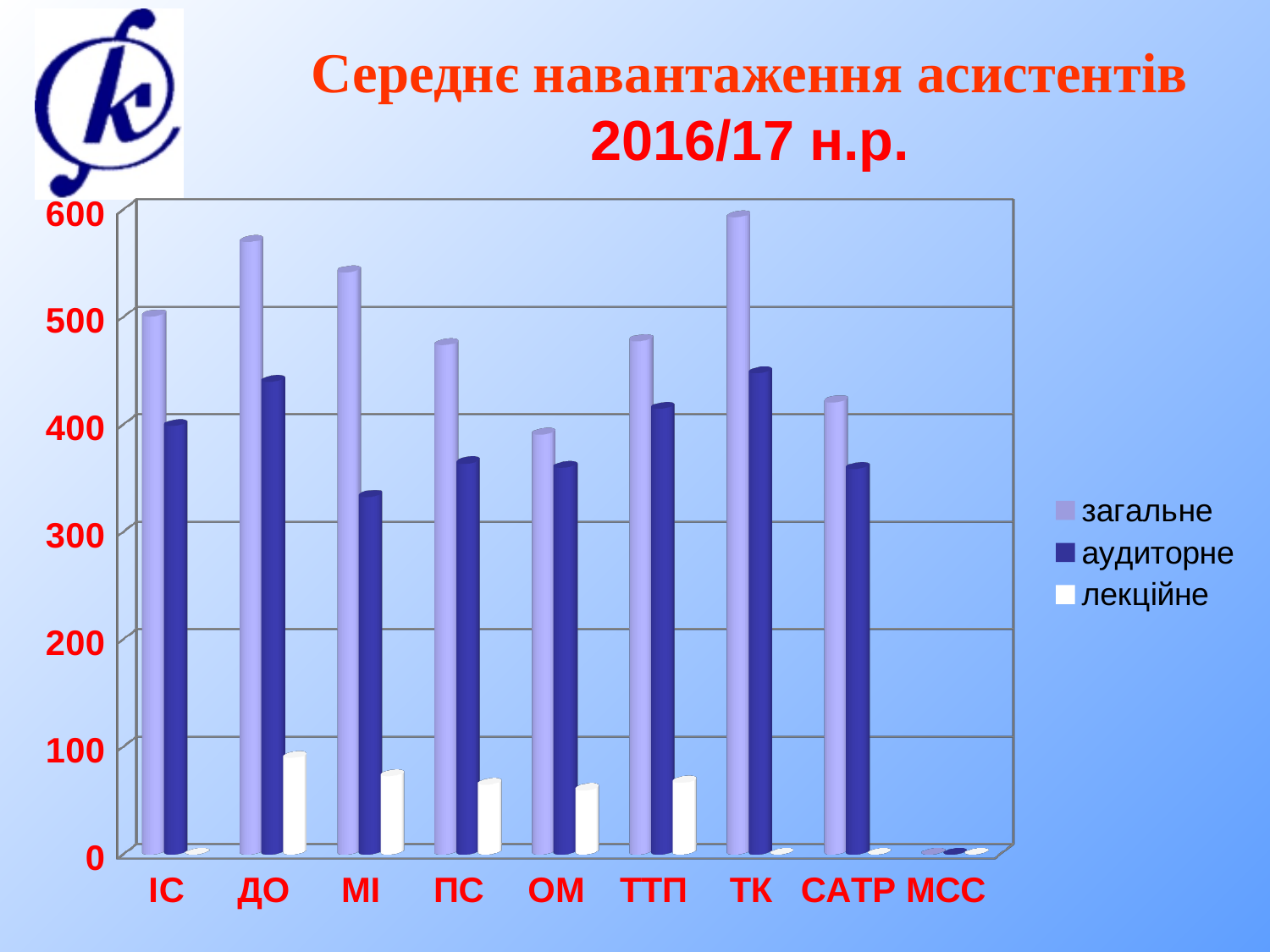
Which is larger, the аудиторне value for ДО or the аудиторне value for ПС? ДО What kind of chart is shown on the slide? bar chart How many series does the legend list? 3 Which category has the highest value for the лекційне series? ДО Is the загальне value for ДО greater or less than 500? greater Is the аудиторне value for МІ greater or less than 400? less Which category has the highest value for the загальне series? ТК What is the title of the chart? Середнє навантаження асистентів 2016/17 н.р. How many categories are shown along the x axis? 9 Which category has the lowest value for the загальне series? МСС Which is larger, the загальне value for ОМ or the загальне value for САТР? САТР Is the лекційне value for ДО greater or less than 100? less